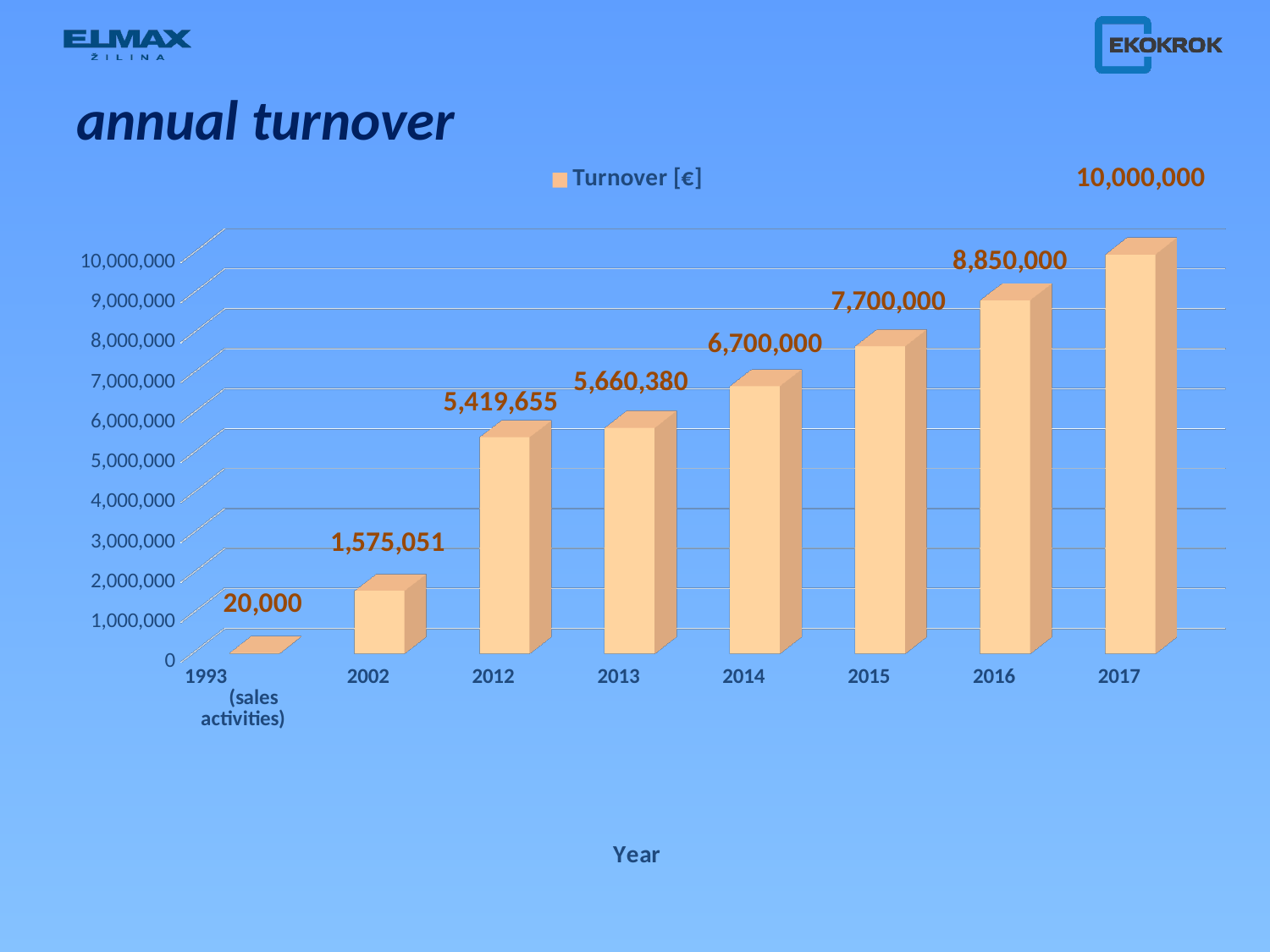
How many years are shown on the x axis? 8 Which year has a larger turnover, 2012 or 2015? 2015 Is the turnover for 2016 greater or less than 8,000,000? greater What is the turnover for 2013? 5,660,380 What is the difference in turnover between 2013 and 2012? 240,725 What is the difference in turnover between 2016 and 2015? 1,150,000 What is the turnover for 2014? 6,700,000 Does the turnover rise or fall from 1993 to 2017? rise What is the turnover for 2002? 1,575,051 What kind of chart is shown on the slide? bar chart Which year has the highest turnover? 2017 Which year has the lowest turnover? 1993